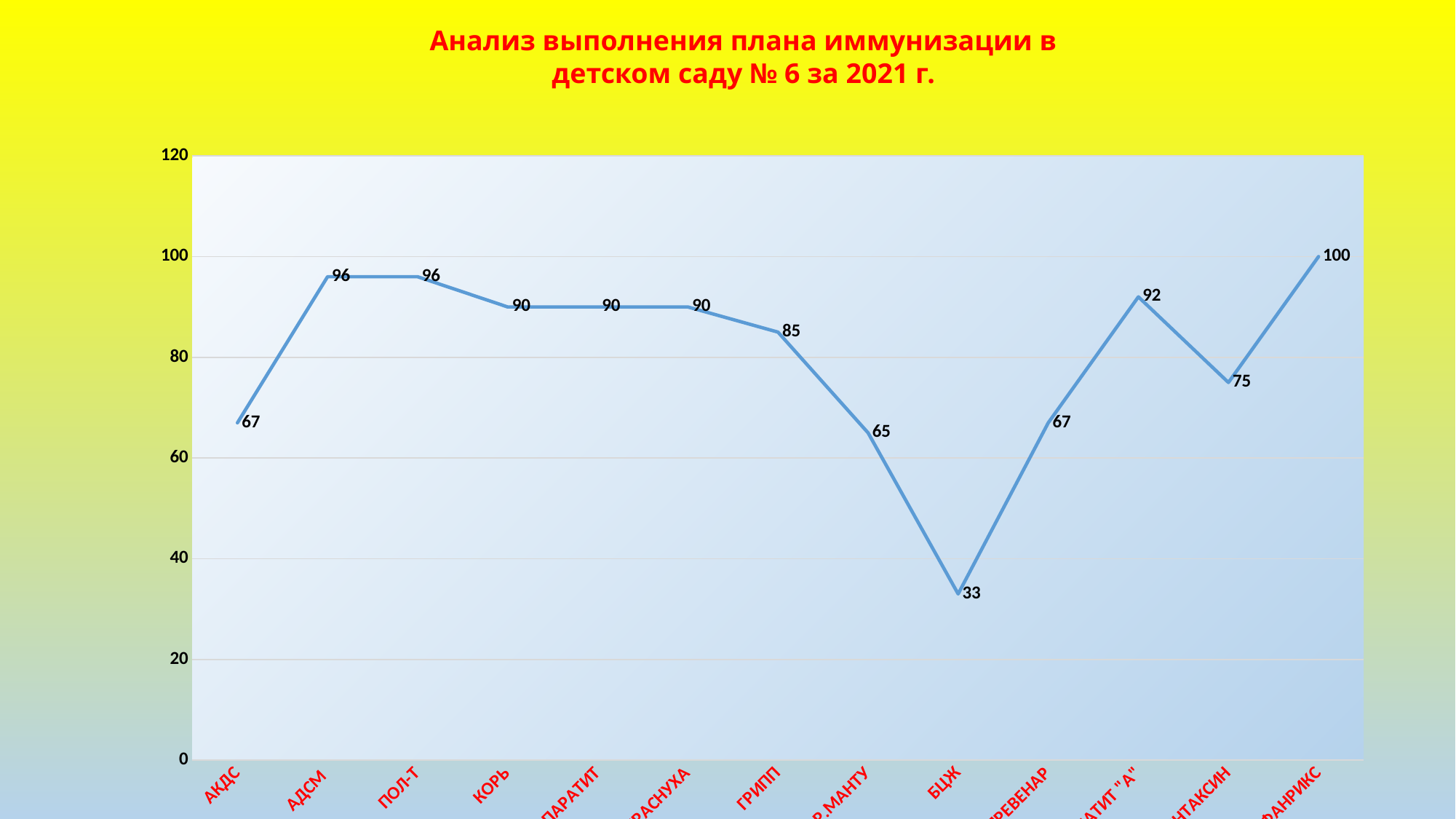
What is the difference between the values for АДСМ and АКДС? 29 Does the line rise or fall from АКДС to АДСМ? rise Which category has the lowest value? БЦЖ What is the highest value plotted on the chart? 100 How many data points are plotted on the chart? 13 What is the value for ПОЛ-Т? 96 What is the value for АКДС? 67 What is the value for БЦЖ? 33 Which is larger, the value for АДСМ or the value for КОРЬ? АДСМ What is the value for КОРЬ? 90 What kind of chart is shown on the slide? line chart What is the value for ГРИПП? 85